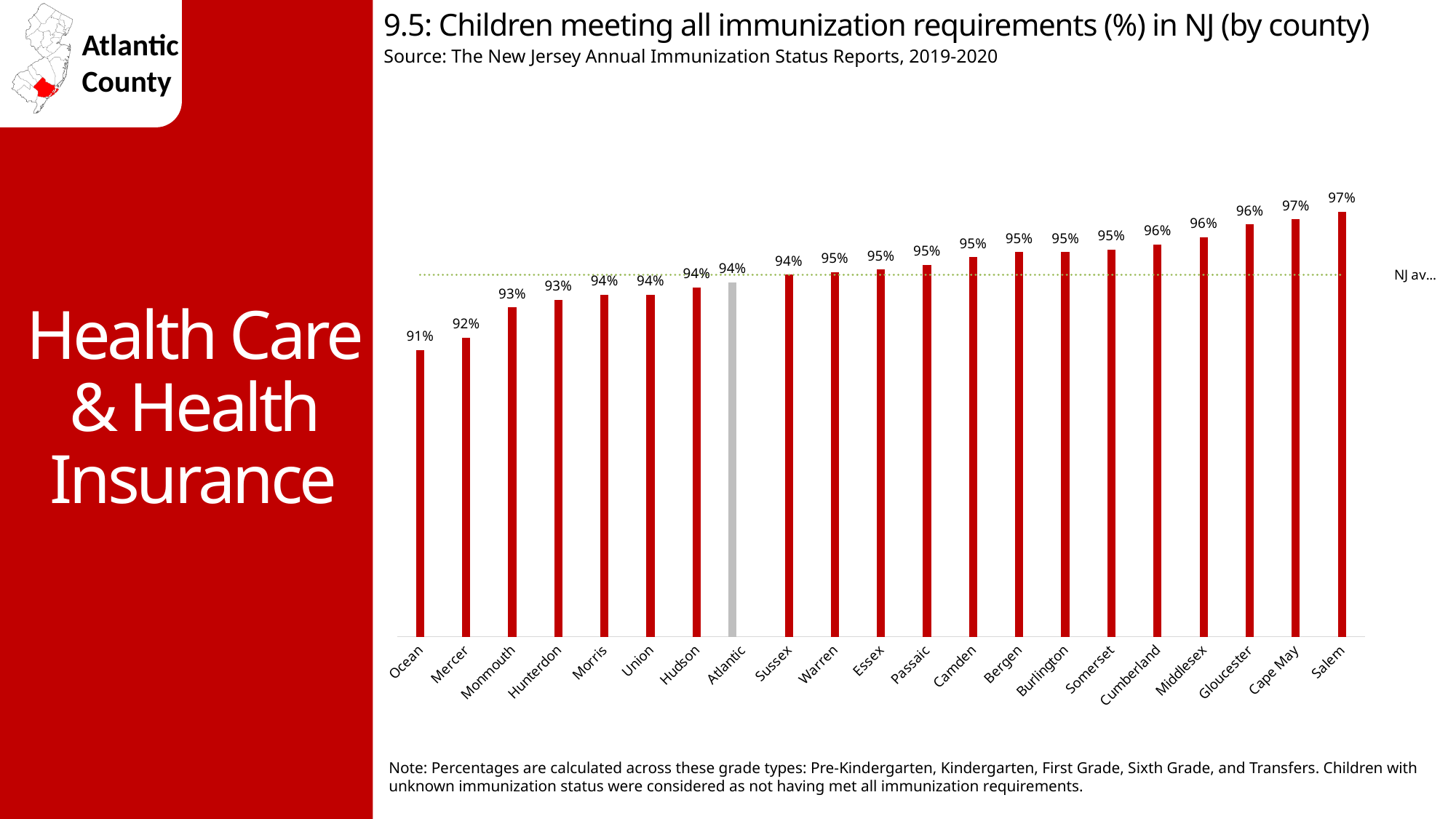
Which county has the lowest percentage of children meeting all immunization requirements? Ocean Which county's bar is coloured grey instead of red? Atlantic How many counties are shown on the chart? 21 What is the value shown for Salem County? 97% What percentage of children met all immunization requirements in Atlantic County? 94% What kind of chart is shown on the slide? Bar chart What is the difference in percentage points between Atlantic and Ocean? 3 percentage points What is the value shown for Ocean County? 91% Which has a higher value, Mercer or Ocean? Mercer What is the difference in percentage points between Salem and Ocean? 6 percentage points Which has a higher value, Atlantic or Cape May? Cape May What percentage is shown for Cumberland County? 96%